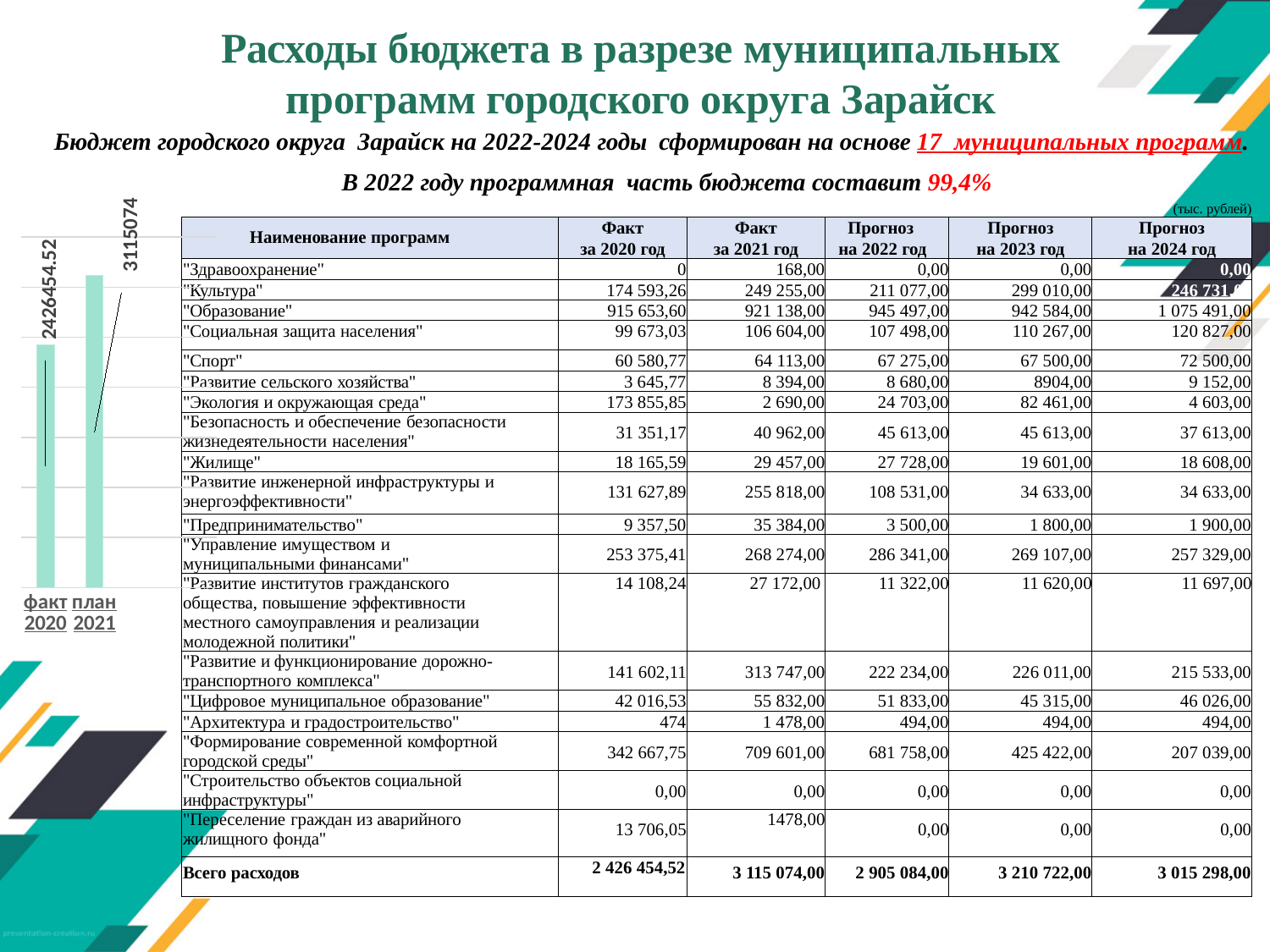
In the bar chart on the left, which category has the lowest value? факт 2020 In the bar chart on the left, what is the value for факт 2020? 2426454.52 In the bar chart on the left, which category has the highest value? план 2021 In the bar chart on the left, what is the difference between план 2021 and факт 2020? 688619.48 In the bar chart on the left, do the values rise or fall from факт 2020 to план 2021? rise In the bar chart on the left, what is the value for план 2021? 3115074 How many bars are plotted in the bar chart on the left? 2 In the bar chart on the left, which is larger: факт 2020 or план 2021? план 2021 What colour are the bars in the bar chart on the left? light green What kind of chart is shown on the left side of the slide? bar chart